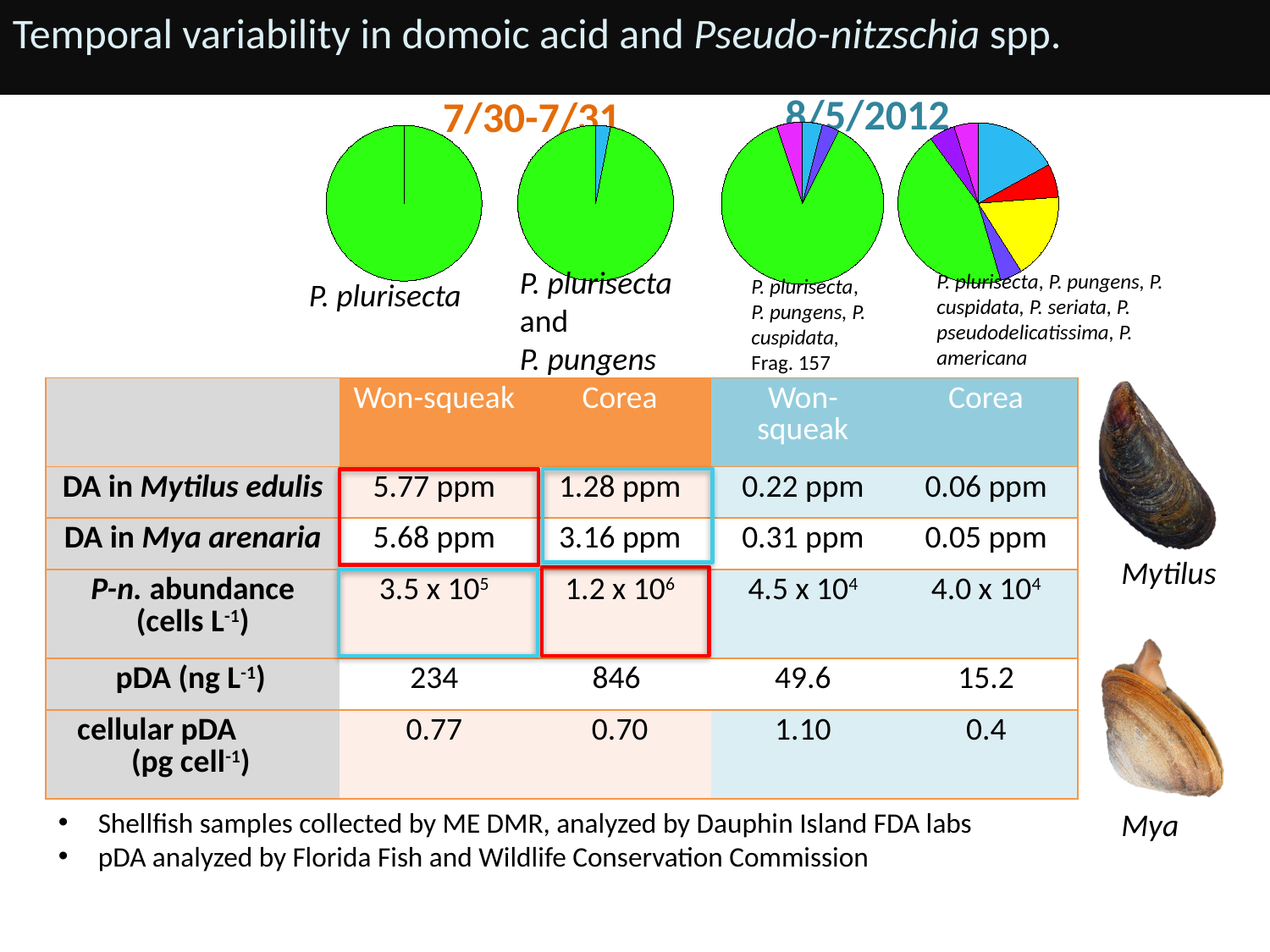
Which date label is shown above the two right pie charts? 8/5/2012 Which of the four pie charts has the most slices? the rightmost pie chart What kind of chart is used to show the Pseudo-nitzschia species composition on this slide? pie chart Which species makes up the leftmost pie chart (7/30-7/31)? P. plurisecta In the rightmost pie chart (8/5/2012), which colour occupies the largest share? green How many taxa are listed in the caption of the second pie chart from the left? 2 In the second pie chart from the left (P. plurisecta and P. pungens), which slice is larger, the green one or the blue one? green How many pie charts are shown on the slide? 4 Which date label is shown above the two left pie charts? 7/30-7/31 How many taxa are listed in the caption of the third pie chart from the left? 4